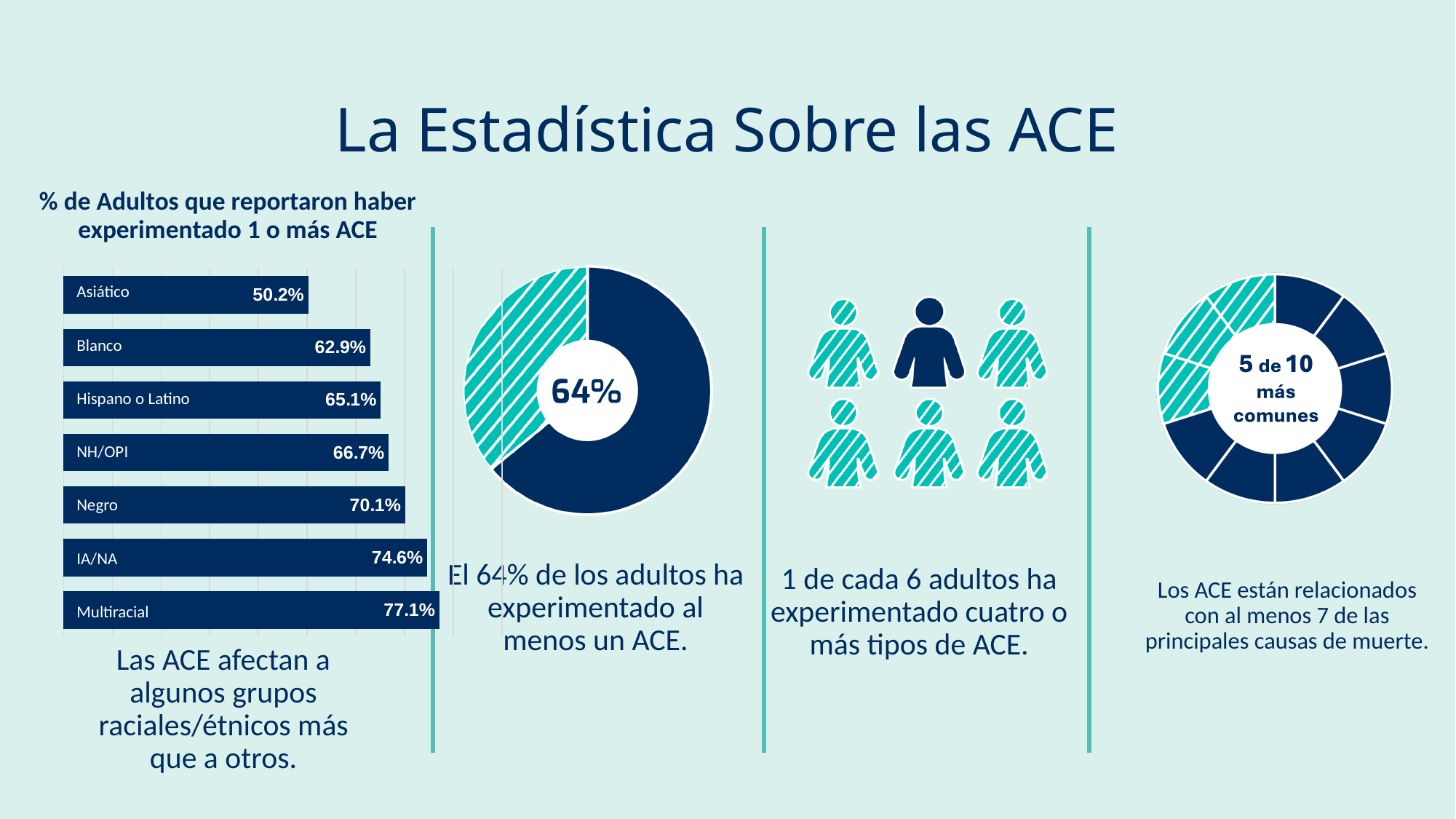
How many categories are shown in the bar chart on the left? 7 What percentage is printed in the center of the donut chart in the second panel? 64% In the bar chart on the left, which category has the lowest value? Asiático In the bar chart on the left, what is the difference between the values for IA/NA and Negro? 4.5% In the bar chart on the left, which is larger: the value for Blanco or the value for Hispano o Latino? Hispano o Latino In the bar chart '% de Adultos que reportaron haber experimentado 1 o más ACE', what is the value for NH/OPI? 66.7% In the bar chart on the left, what is the difference between the values for Multiracial and Asiático? 26.9% What kind of chart is the chart on the left of the slide? Bar chart What is the title of the bar chart on the left? % de Adultos que reportaron haber experimentado 1 o más ACE In the bar chart '% de Adultos que reportaron haber experimentado 1 o más ACE', what is the value for Asiático? 50.2% In the bar chart '% de Adultos que reportaron haber experimentado 1 o más ACE', what is the value for Negro? 70.1% In the bar chart on the left, which category has the highest value? Multiracial